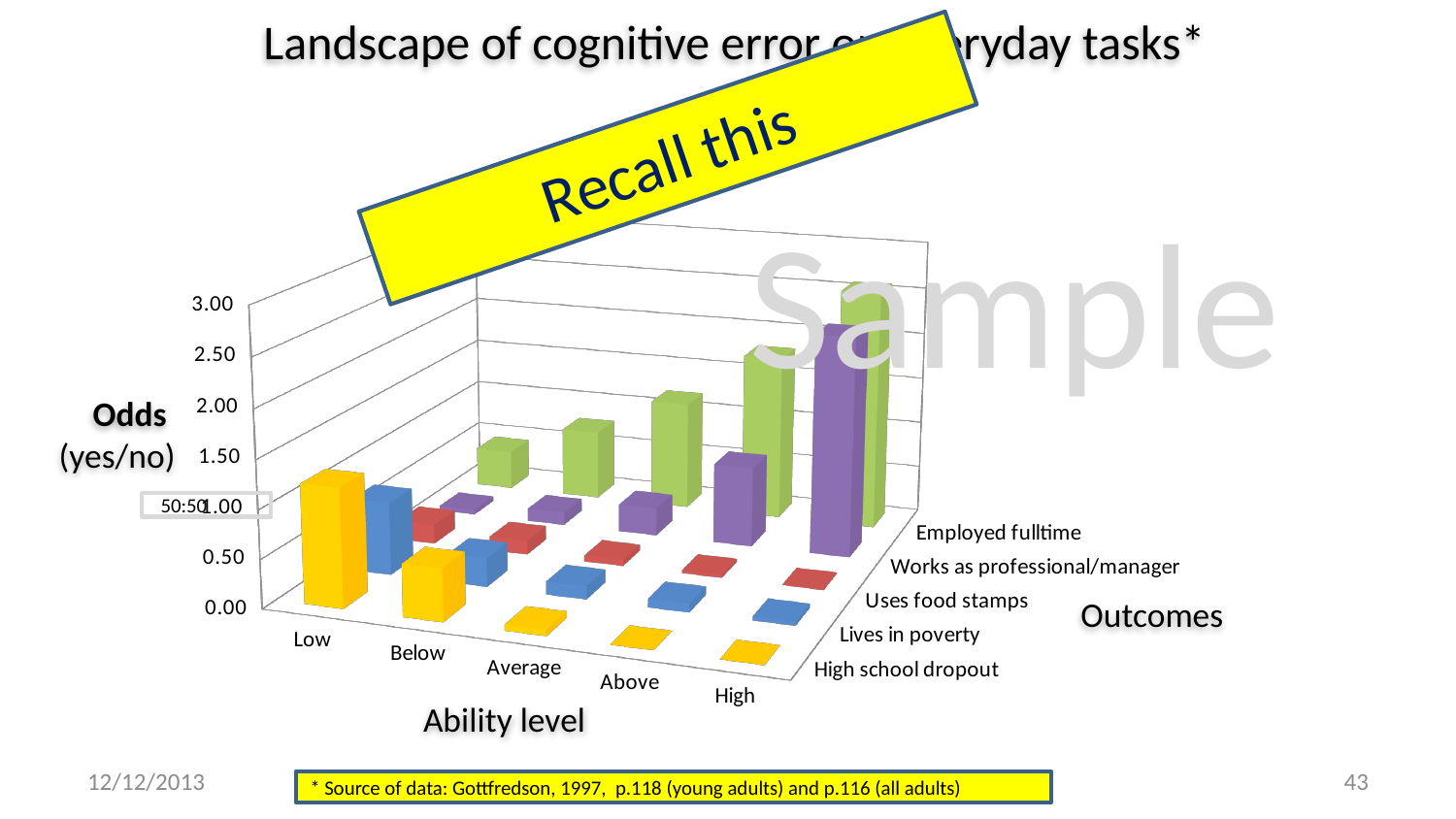
Which ability level has the lowest odds for High school dropout? High Is the value for Employed fulltime at the High ability level greater or less than 1.50? greater How many outcome series are plotted in the chart? 5 How many ability levels are shown along the x axis of the chart? 5 Do the odds for High school dropout rise or fall as ability level goes from Low to High? fall Which is larger: the odds for High school dropout at Low ability or at High ability? Low Which ability level has the highest odds for High school dropout? Low Which ability level has the highest odds for Employed fulltime? High What is the label on the vertical axis of the chart? Odds (yes/no) Do the odds for Employed fulltime rise or fall as ability level goes from Low to High? rise Is the value for High school dropout at the High ability level greater or less than 0.50? less What kind of chart is shown on the slide? bar chart